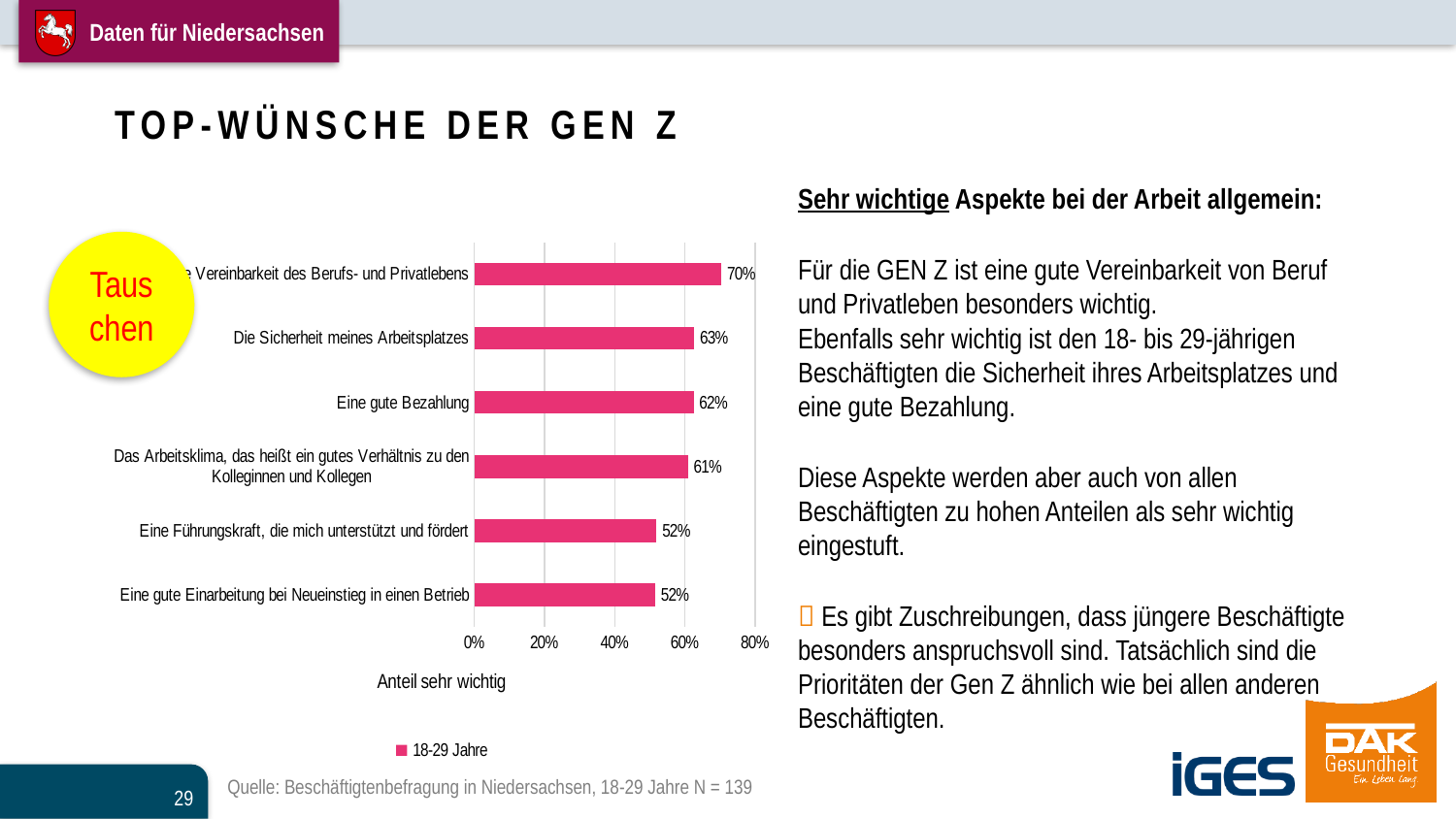
What is the value for "Eine Führungskraft, die mich unterstützt und fördert"? 52% What is the value for "Die Sicherheit meines Arbeitsplatzes"? 63% How many categories are shown in the chart? 6 How many series does the legend list? 1 What kind of chart is shown on the slide? Bar chart Which is larger: the value for "Die Sicherheit meines Arbeitsplatzes" or for "Eine gute Bezahlung"? Die Sicherheit meines Arbeitsplatzes What is the value for "Eine gute Bezahlung"? 62% What series name is shown in the chart legend? 18-29 Jahre What is the difference between the value for "Die Sicherheit meines Arbeitsplatzes" and the value for "Eine gute Einarbeitung bei Neueinstieg in einen Betrieb"? 11 percentage points What is the value for the category about Vereinbarkeit des Berufs- und Privatlebens? 70% Which category has the highest value? Vereinbarkeit des Berufs- und Privatlebens What is the value for "Das Arbeitsklima, das heißt ein gutes Verhältnis zu den Kolleginnen und Kollegen"? 61%